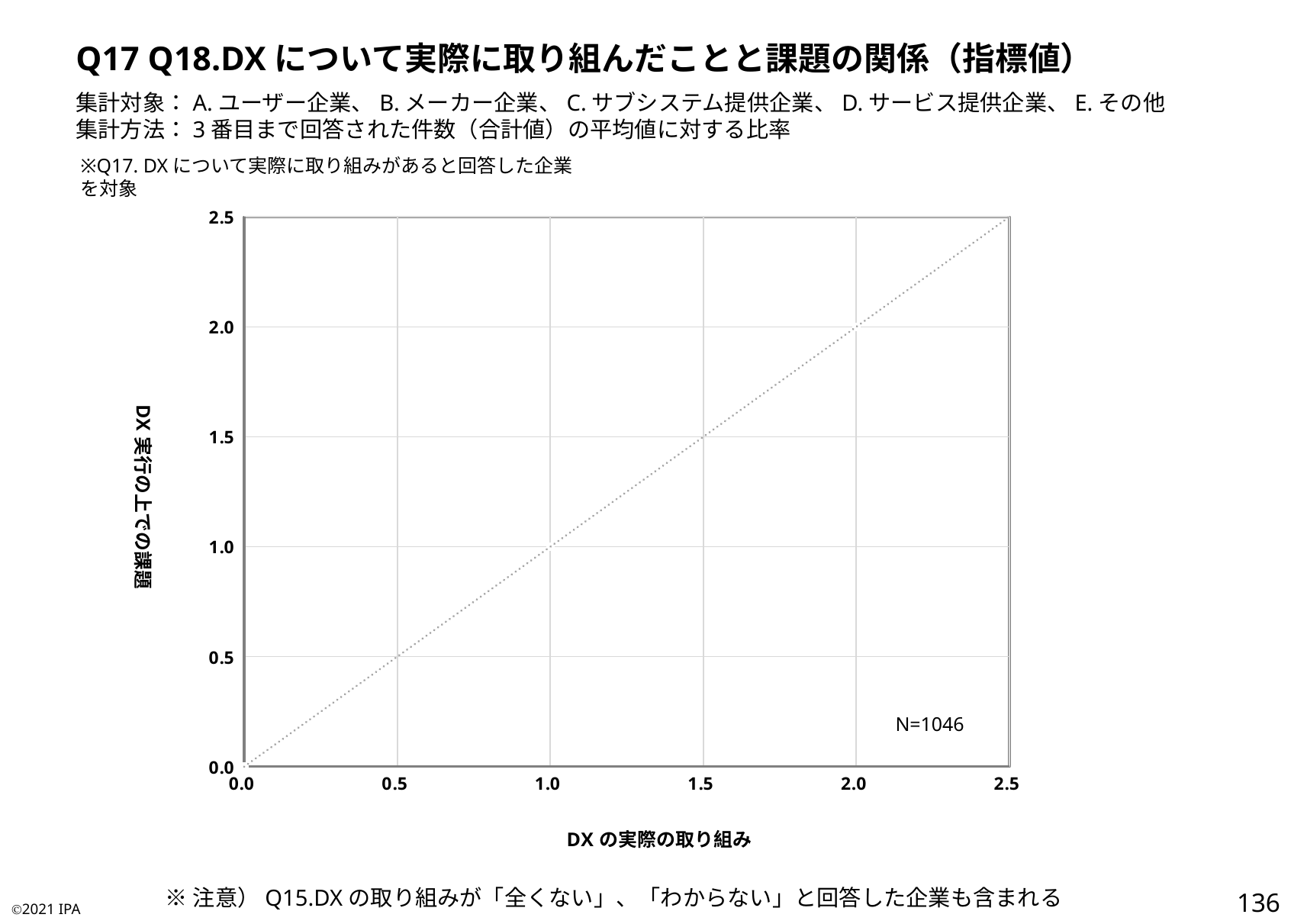
What sample size (N) is printed inside the chart area? N=1046 What is the label of the horizontal (x) axis of the chart? DX の実際の取り組み What is the maximum value shown on the x axis of the chart? 2.5 What kind of chart is shown on the slide? scatter chart What is the label of the vertical (y) axis of the chart? DX 実行の上での課題 What is the maximum value shown on the y axis of the chart? 2.5